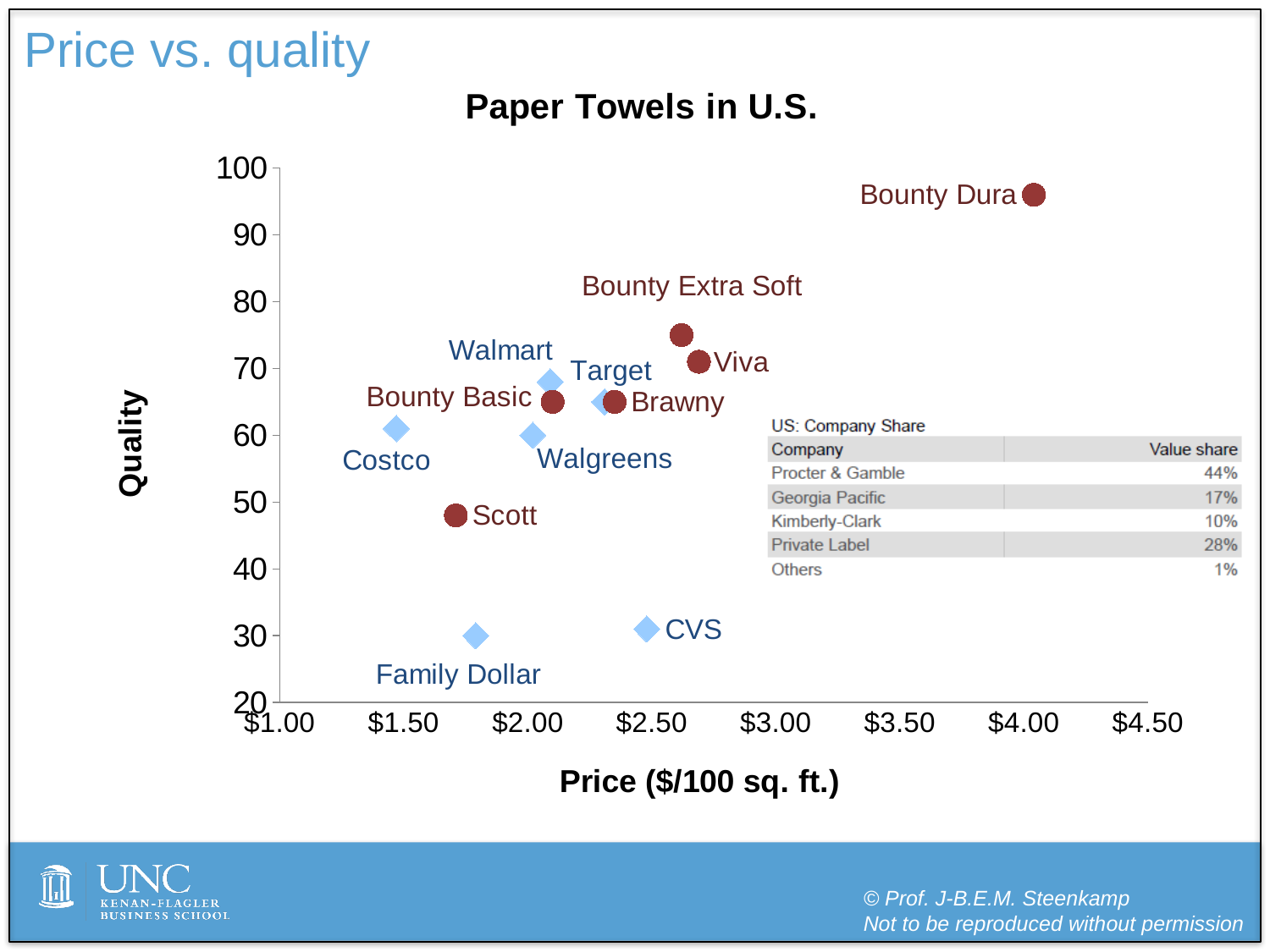
Is the quality value for Bounty Dura greater or less than 90? greater According to the inset table on the chart, what is the value share of Procter & Gamble? 44% What kind of chart is shown on the slide? Scatter chart Which has the higher quality, Walmart or Walgreens? Walmart Which brand has the lowest price on the chart? Costco Which brand has the highest quality on the chart? Bounty Dura Is the price for Bounty Dura greater or less than $3.50? greater What is the title of the chart? Paper Towels in U.S. What is the label of the x axis of the chart? Price ($/100 sq. ft.) How many brands are plotted as points on the chart? 12 Is the price for Family Dollar greater or less than $2.00? less